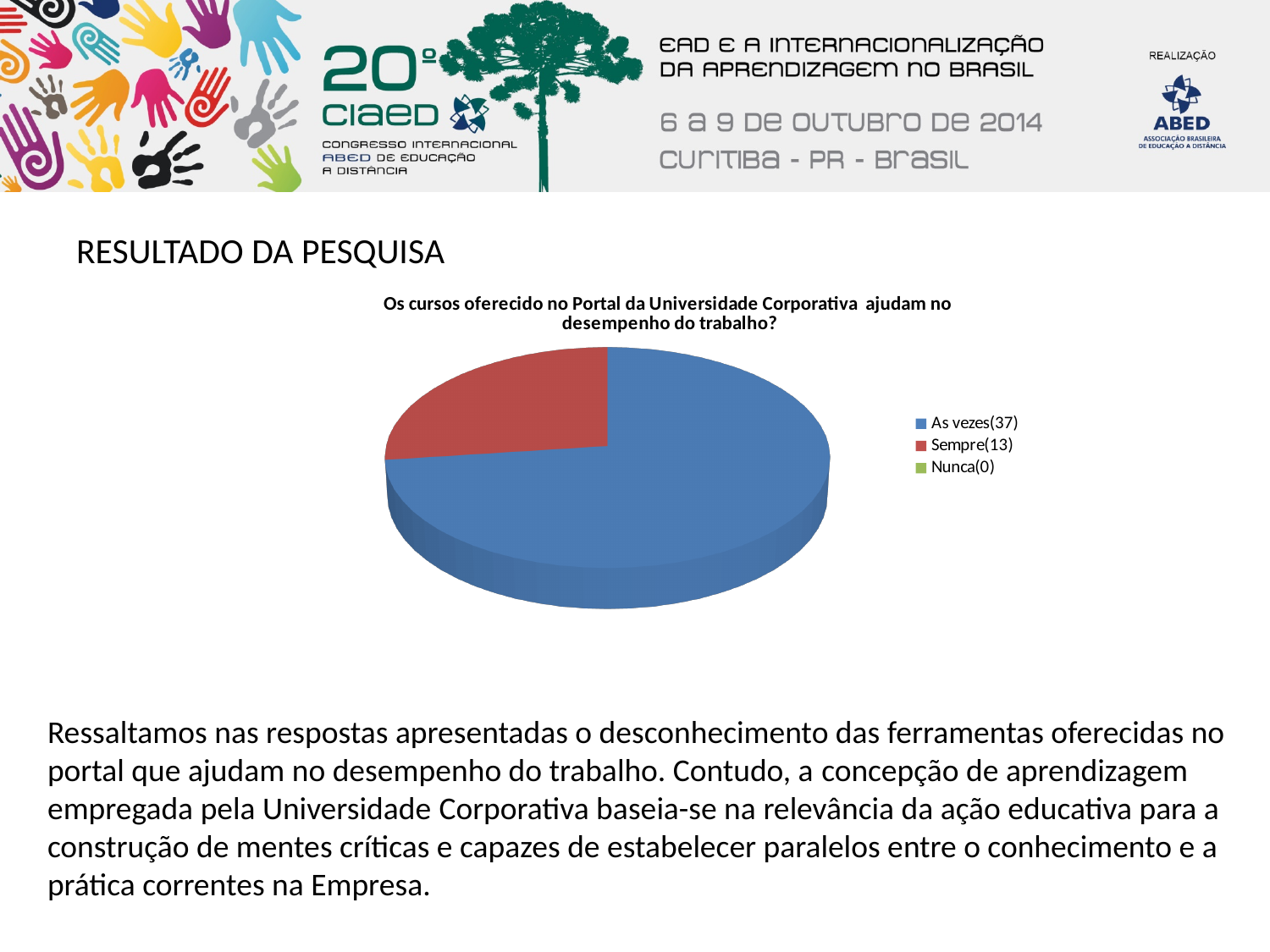
How many responses are recorded for "Sempre"? 13 Which category has the largest slice of the pie? As vezes How many responses are recorded for "Nunca"? 0 Which has more responses, "Sempre" or "As vezes"? As vezes How many categories does the legend of the pie chart list? 3 What is the title of the chart? Os cursos oferecido no Portal da Universidade Corporativa ajudam no desempenho do trabalho? What kind of chart is shown on the slide? pie chart What is the difference between the number of "As vezes" responses and "Sempre" responses? 24 Which category has the smallest value in the pie chart? Nunca What is the total number of responses across all categories in the pie chart? 50 How many responses are recorded for "As vezes"? 37